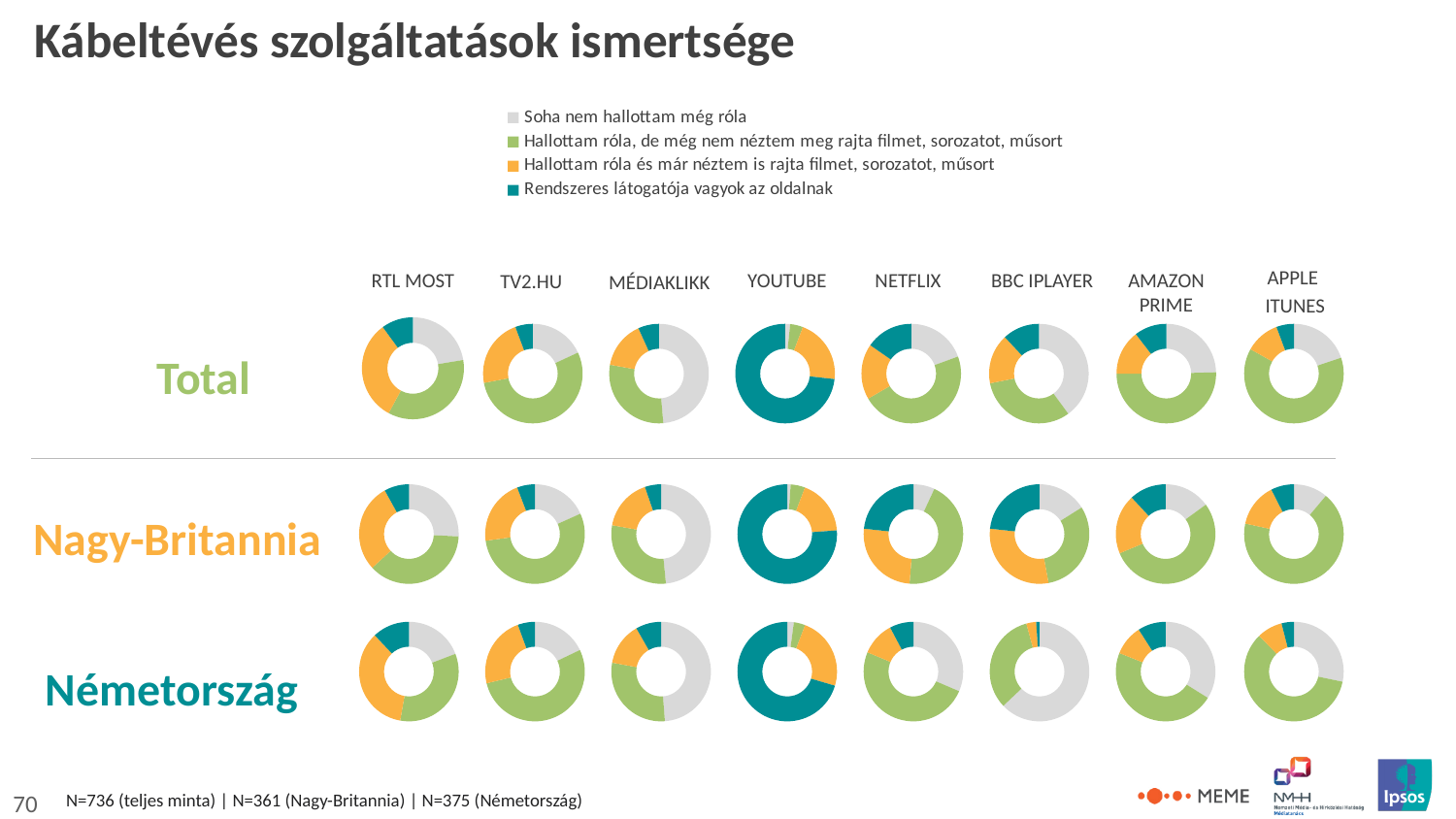
How many response categories does the legend list? 4 How many rows of donut charts (groups) are shown on the slide? 3 For BBC IPLAYER, is the "Soha nem hallottam még róla" share larger in the Nagy-Britannia row or the Németország row? Németország How many services are shown in the Total row? 8 What kind of chart is used to show the awareness of each service on this slide? donut chart Which colour represents "Soha nem hallottam még róla" in the legend? grey In the Németország row, which service has the largest "Soha nem hallottam még róla" share? BBC IPLAYER What is the title of the slide? Kábeltévés szolgáltatások ismertsége For NETFLIX, is the "Rendszeres látogatója vagyok az oldalnak" share larger in the Nagy-Britannia row or the Németország row? Nagy-Britannia In the Total row, which service has the largest "Rendszeres látogatója vagyok az oldalnak" share? YOUTUBE In the Total row, which service has the smallest "Soha nem hallottam még róla" share? YOUTUBE In the Total row for YOUTUBE, which is larger: the "Rendszeres látogatója vagyok az oldalnak" share or the "Soha nem hallottam még róla" share? Rendszeres látogatója vagyok az oldalnak